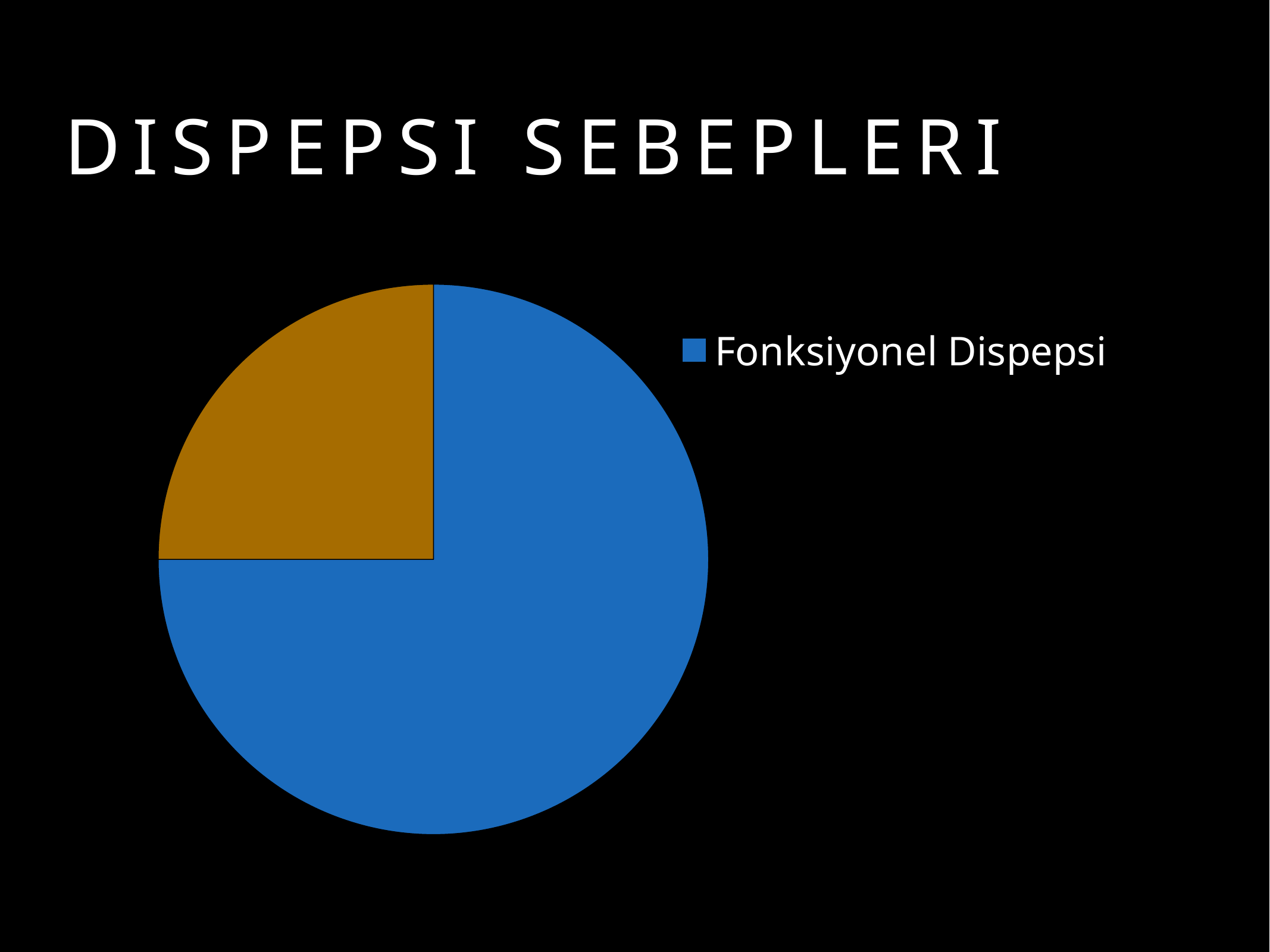
Does the Fonksiyonel Dispepsi slice take up more or less than half of the pie? more What kind of chart is shown on the slide? pie chart How many slices does the pie chart have? 2 Which labelled category has the largest slice in the pie chart? Fonksiyonel Dispepsi What colour is the Fonksiyonel Dispepsi slice in the pie chart? blue How many entries does the legend of the pie chart list? 1 What is the title of the slide containing the pie chart? DISPEPSI SEBEPLERI Is the Fonksiyonel Dispepsi slice larger or smaller than the other slice in the pie chart? larger